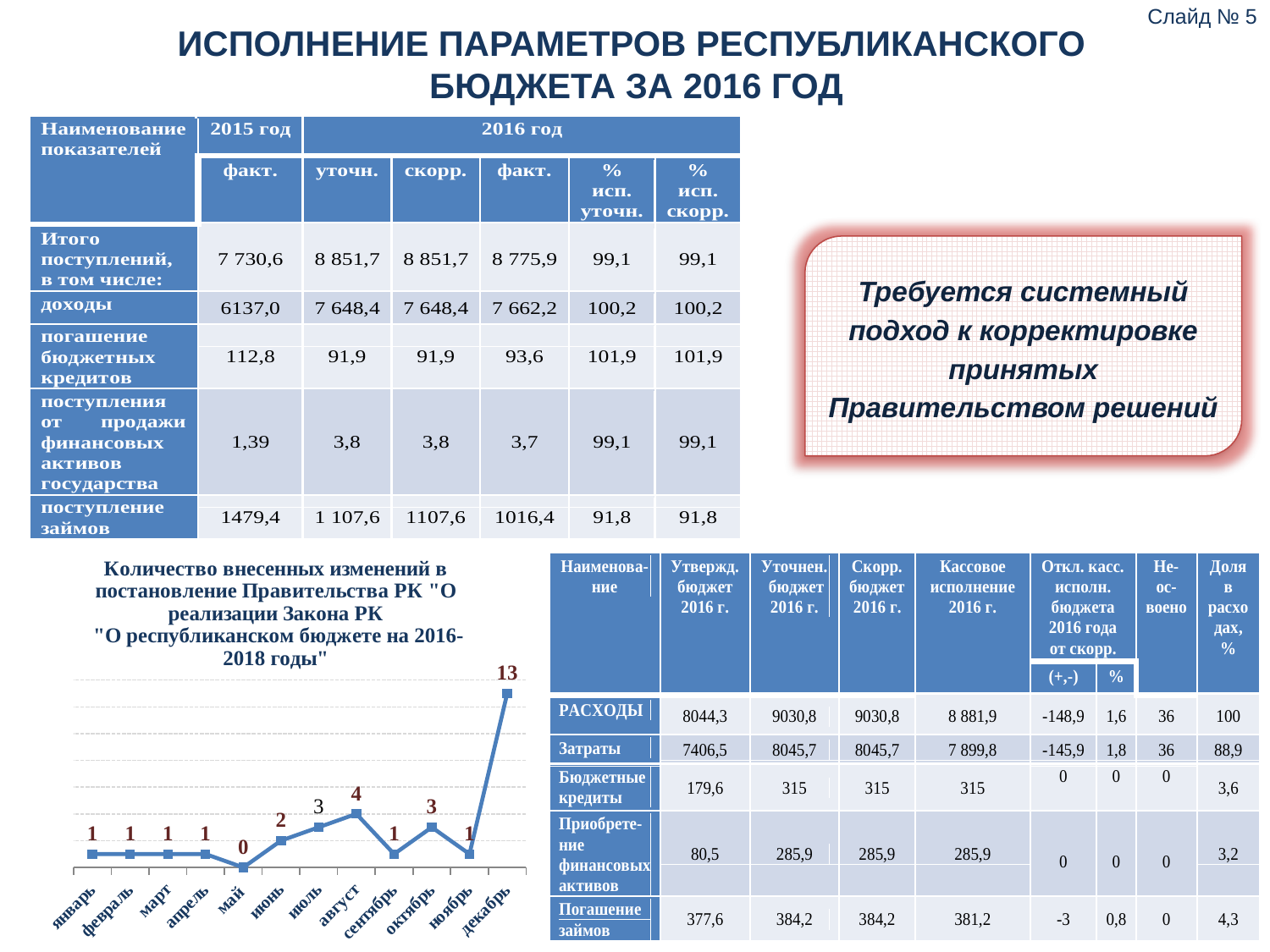
Which month has the lowest value in the line chart? май What is the value for май (May) in the line chart? 0 What is the value for август (August) in the line chart? 4 How many months are plotted on the x axis of the line chart? 12 What is the value for январь (January) in the line chart? 1 What is the value for декабрь (December) in the line chart? 13 What is the difference between the values for декабрь and август in the line chart? 9 What is the value for июнь (June) in the line chart? 2 Which is larger in the line chart, the value for июль or the value for октябрь? they are equal (3) Which month has the highest value in the line chart? декабрь What kind of chart is shown on the slide? line chart Which is larger in the line chart, the value for август or the value for сентябрь? август